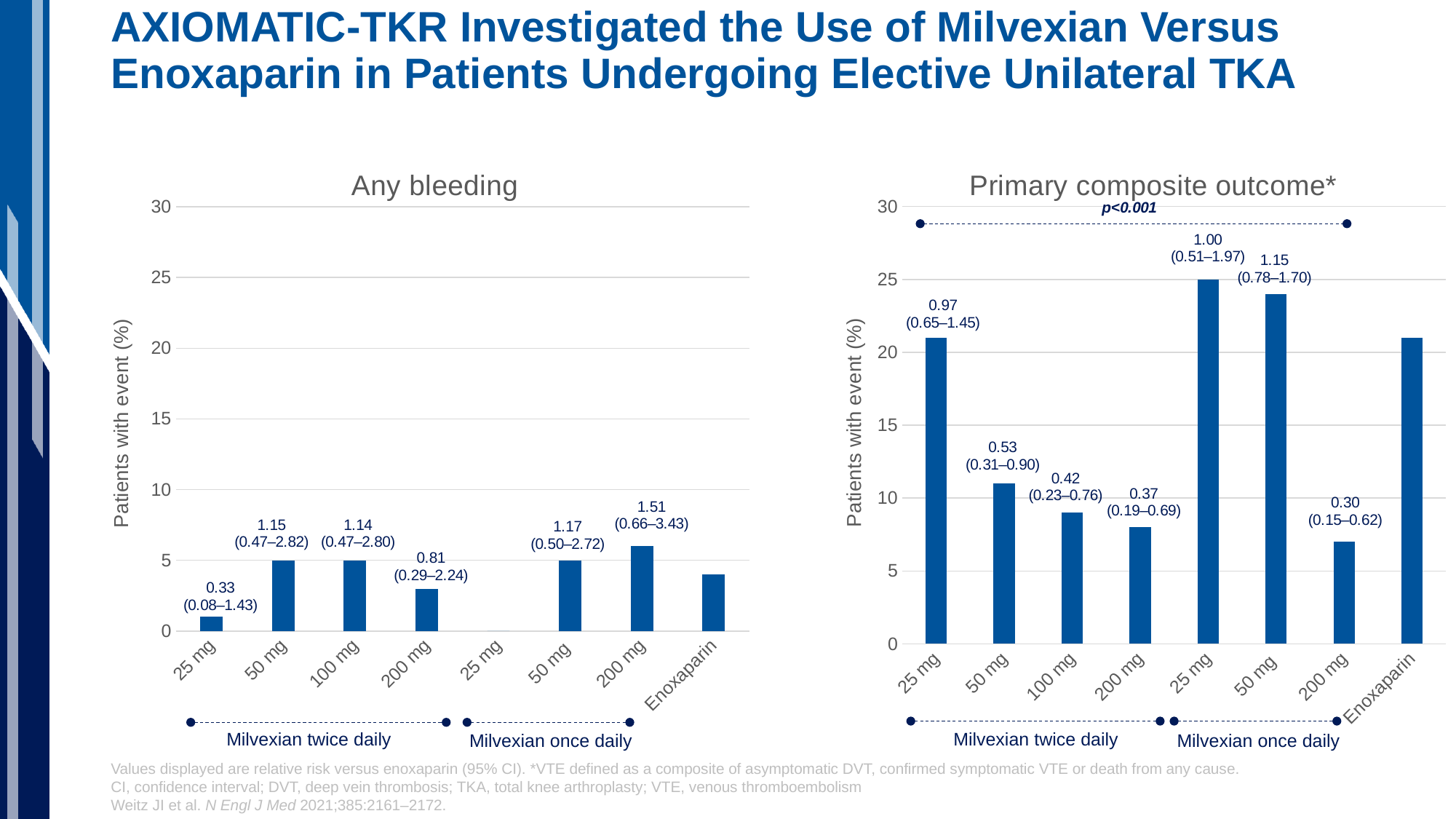
What kind of chart is the Primary composite outcome chart? Bar chart In the Any bleeding chart, which category has the tallest bar? 200 mg (Milvexian once daily) In the Any bleeding chart, is the value for Enoxaparin greater or less than 5? less In the Primary composite outcome chart, is the value for 25 mg Milvexian once daily greater or less than 20? greater What p-value is printed on the Primary composite outcome chart? p<0.001 In the Any bleeding chart, what relative risk (95% CI) is printed above the 25 mg Milvexian twice daily bar? 0.33 (0.08–1.43) In the Primary composite outcome chart, what relative risk (95% CI) is printed above the 200 mg Milvexian once daily bar? 0.30 (0.15–0.62) In the Primary composite outcome chart, what relative risk (95% CI) is printed above the 50 mg Milvexian twice daily bar? 0.53 (0.31–0.90) In the Any bleeding chart, what relative risk (95% CI) is printed above the 200 mg Milvexian once daily bar? 1.51 (0.66–3.43) How many categories are shown on the x axis of the Any bleeding chart? 8 In the Primary composite outcome chart, which is larger, the bar for 25 mg Milvexian twice daily or the bar for 50 mg Milvexian twice daily? 25 mg Milvexian twice daily In the Primary composite outcome chart, is the value for 200 mg Milvexian once daily greater or less than 10? less